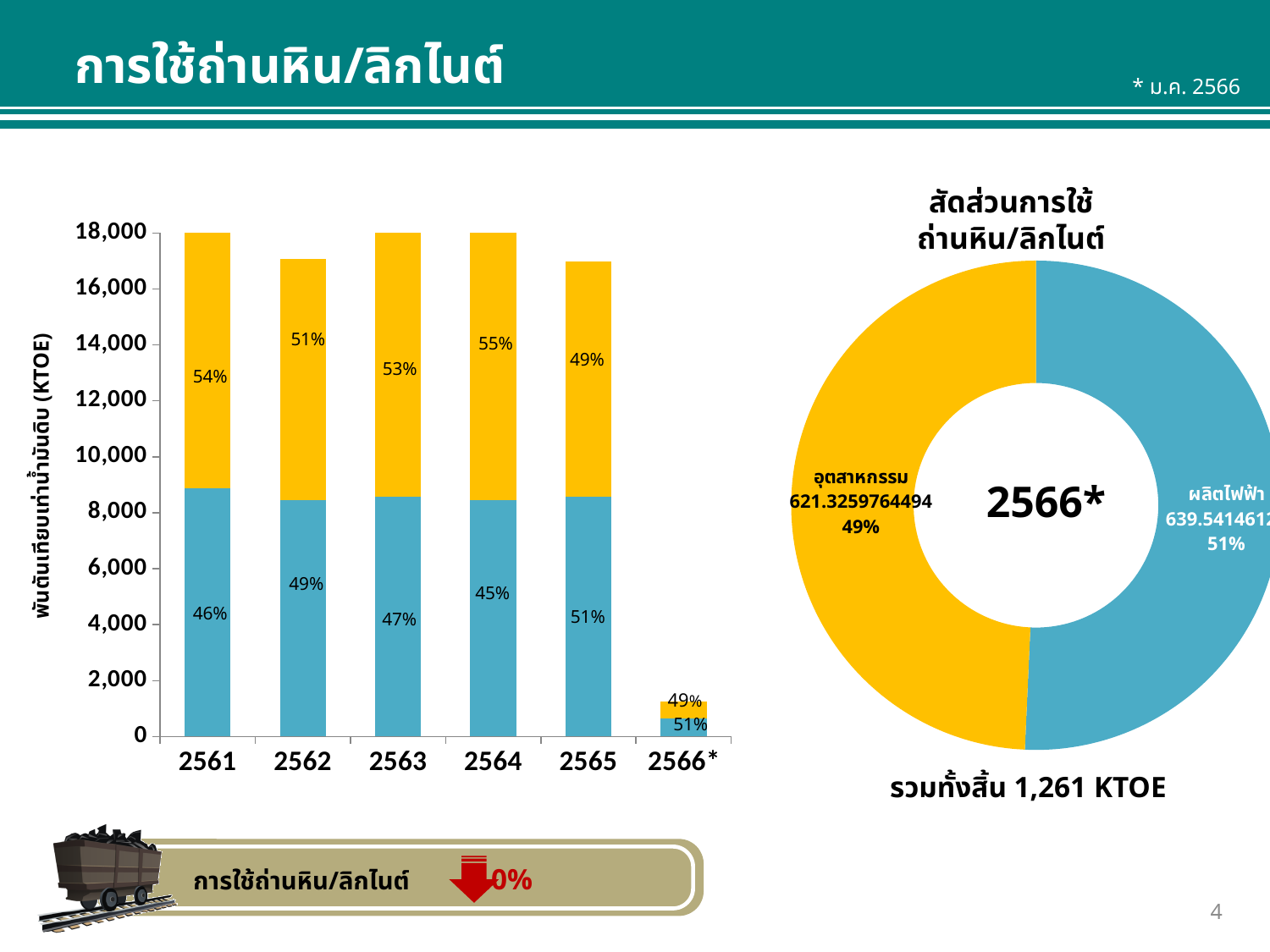
In the bar chart on the left, what percentage is labelled on the blue (bottom) segment for 2561? 46% In the donut chart titled สัดส่วนการใช้ถ่านหิน/ลิกไนต์, which segment is larger, อุตสาหกรรม or ผลิตไฟฟ้า? ผลิตไฟฟ้า What kind of chart is the chart on the left of the slide? Stacked bar chart In the bar chart on the left, is the total height of the 2562 bar greater or less than 16,000? greater In the bar chart on the left, how many years are shown on the x axis? 6 What is the y-axis label of the bar chart on the left? พันตันเทียบเท่าน้ำมันดิบ (KTOE) In the donut chart titled สัดส่วนการใช้ถ่านหิน/ลิกไนต์, what share does อุตสาหกรรม have? 49% In the bar chart on the left, is the total height of the 2566* bar greater or less than 2,000? less In the bar chart on the left, what percentage is labelled on the yellow (top) segment for 2564? 55% What total is stated below the donut chart titled สัดส่วนการใช้ถ่านหิน/ลิกไนต์? 1,261 KTOE In the bar chart on the left, what percentage is labelled on the blue (bottom) segment for 2565? 51% In the bar chart on the left, which year has the lowest total bar? 2566*